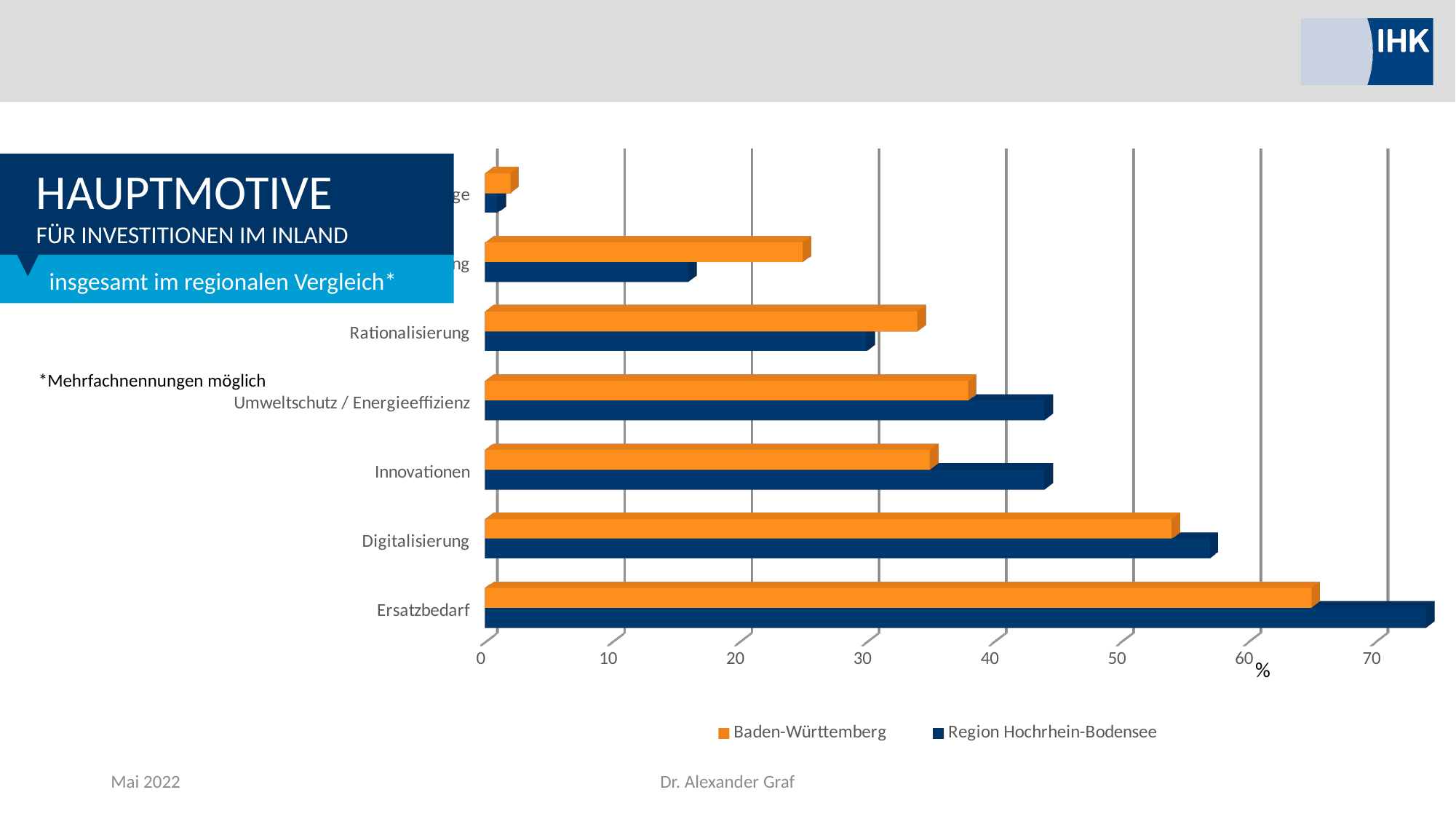
How many series does the legend list? 2 Is the value for Innovationen for Region Hochrhein-Bodensee greater or less than 40? greater For Innovationen, which series has the larger value, Baden-Württemberg or Region Hochrhein-Bodensee? Region Hochrhein-Bodensee Is the value for Ersatzbedarf for Region Hochrhein-Bodensee greater or less than 70? greater For Rationalisierung, which series has the larger value, Baden-Württemberg or Region Hochrhein-Bodensee? Baden-Württemberg What kind of chart is shown on the slide? bar chart For Digitalisierung, which series has the larger value, Baden-Württemberg or Region Hochrhein-Bodensee? Region Hochrhein-Bodensee Which category has the highest value for Baden-Württemberg? Ersatzbedarf Which category has the highest value for Region Hochrhein-Bodensee? Ersatzbedarf Which series is shown in orange? Baden-Württemberg Is the value for Ersatzbedarf for Baden-Württemberg greater or less than 60? greater